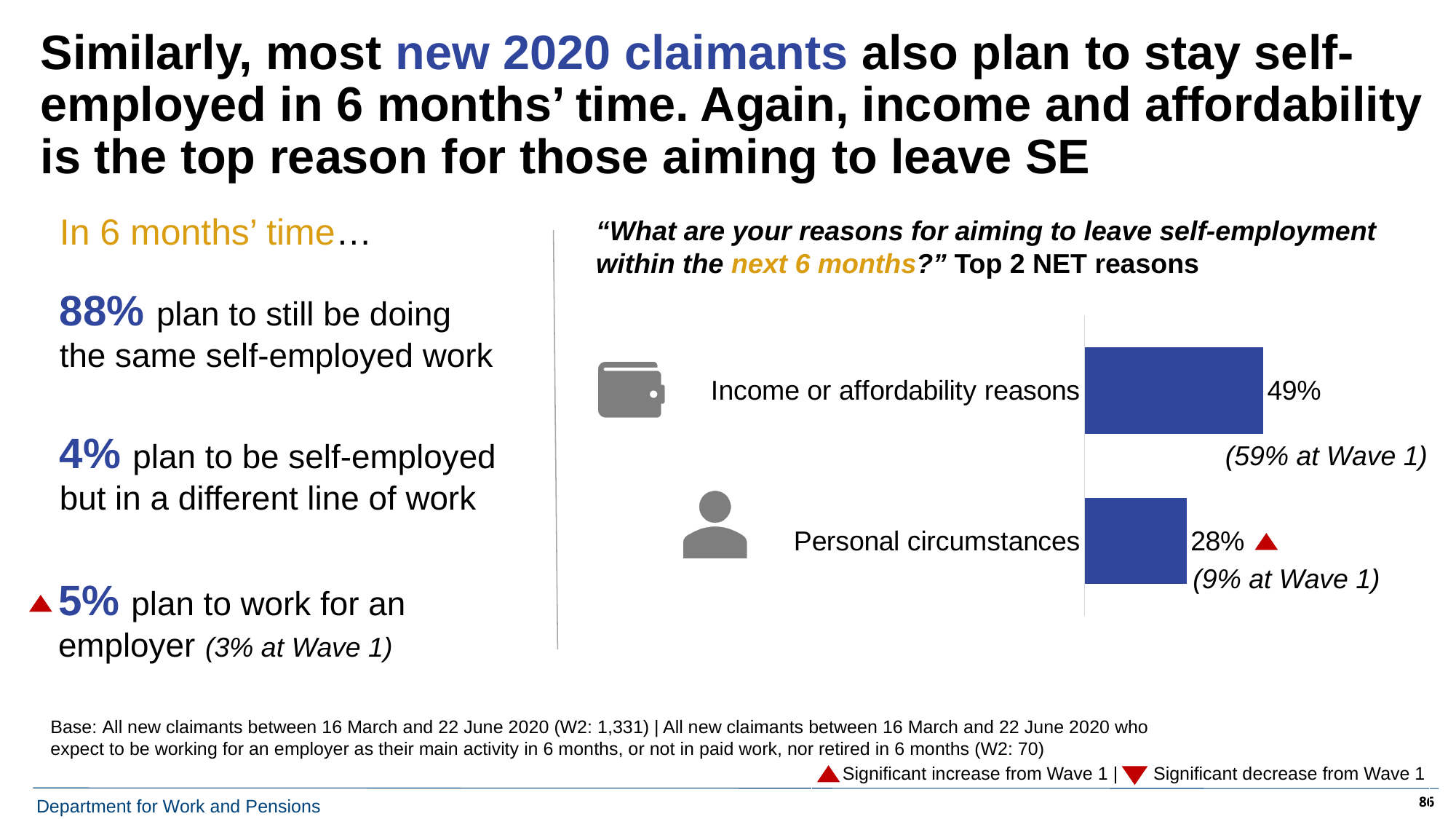
What kind of chart is used to show the top 2 NET reasons? Bar chart Which reason has the lowest value in the bar chart? Personal circumstances Which is larger in the bar chart: Income or affordability reasons or Personal circumstances? Income or affordability reasons Which reason has the highest value in the bar chart? Income or affordability reasons What colour are the bars in the chart? Blue What was the Wave 1 value for Income or affordability reasons, as noted next to the bar? 59% What was the Wave 1 value for Personal circumstances, as noted next to the bar? 9% What is the difference in percentage points between Income or affordability reasons and Personal circumstances? 21 Which reason in the bar chart is marked with a red triangle indicating a significant increase from Wave 1? Personal circumstances How many reasons are plotted in the bar chart? 2 What percentage is shown for Income or affordability reasons in the bar chart? 49% What percentage is shown for Personal circumstances in the bar chart? 28%